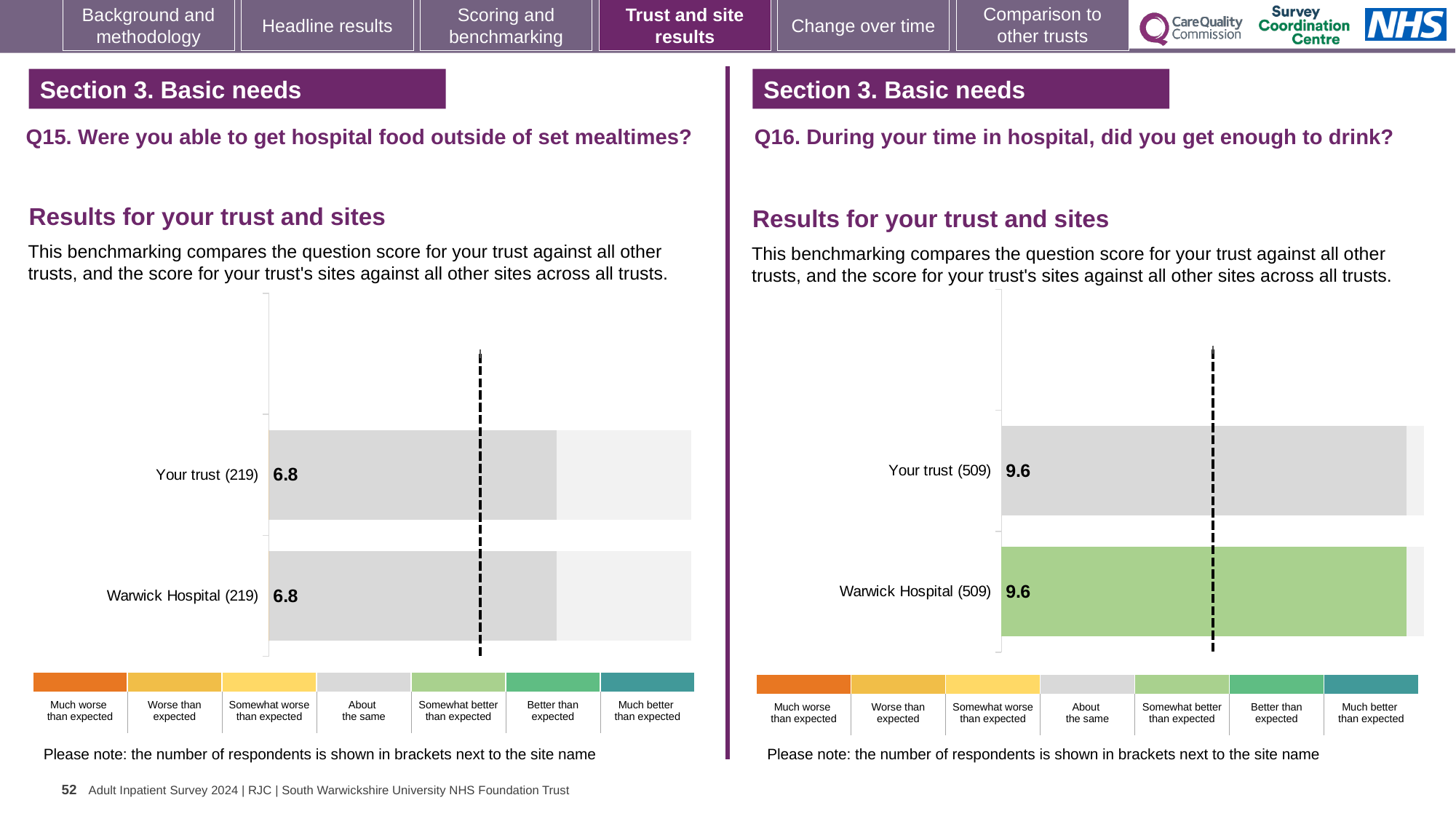
In the Q15 chart on the left, how many respondents are shown in brackets for Your trust? 219 In the Q16 chart on the right, what is the score for Warwick Hospital? 9.6 In the Q16 chart on the right, what is the score for Your trust? 9.6 In the Q16 chart on the right, what is the difference between the score for Warwick Hospital and the score for Your trust? 0 In the Q15 chart on the left, what is the difference between the score for Your trust and the score for Warwick Hospital? 0 In the Q15 chart on the left, what is the score for Your trust? 6.8 How many bars are plotted in the Q16 chart on the right? 2 In the Q16 chart on the right, which benchmark category does the green colour of the Warwick Hospital bar correspond to in the key? Somewhat better than expected What kind of chart is the Q16 chart on the right? Bar chart In the Q16 chart on the right, how many respondents are shown in brackets for Warwick Hospital? 509 In the Q15 chart on the left, what is the score for Warwick Hospital? 6.8 How many bars are plotted in the Q15 chart on the left? 2